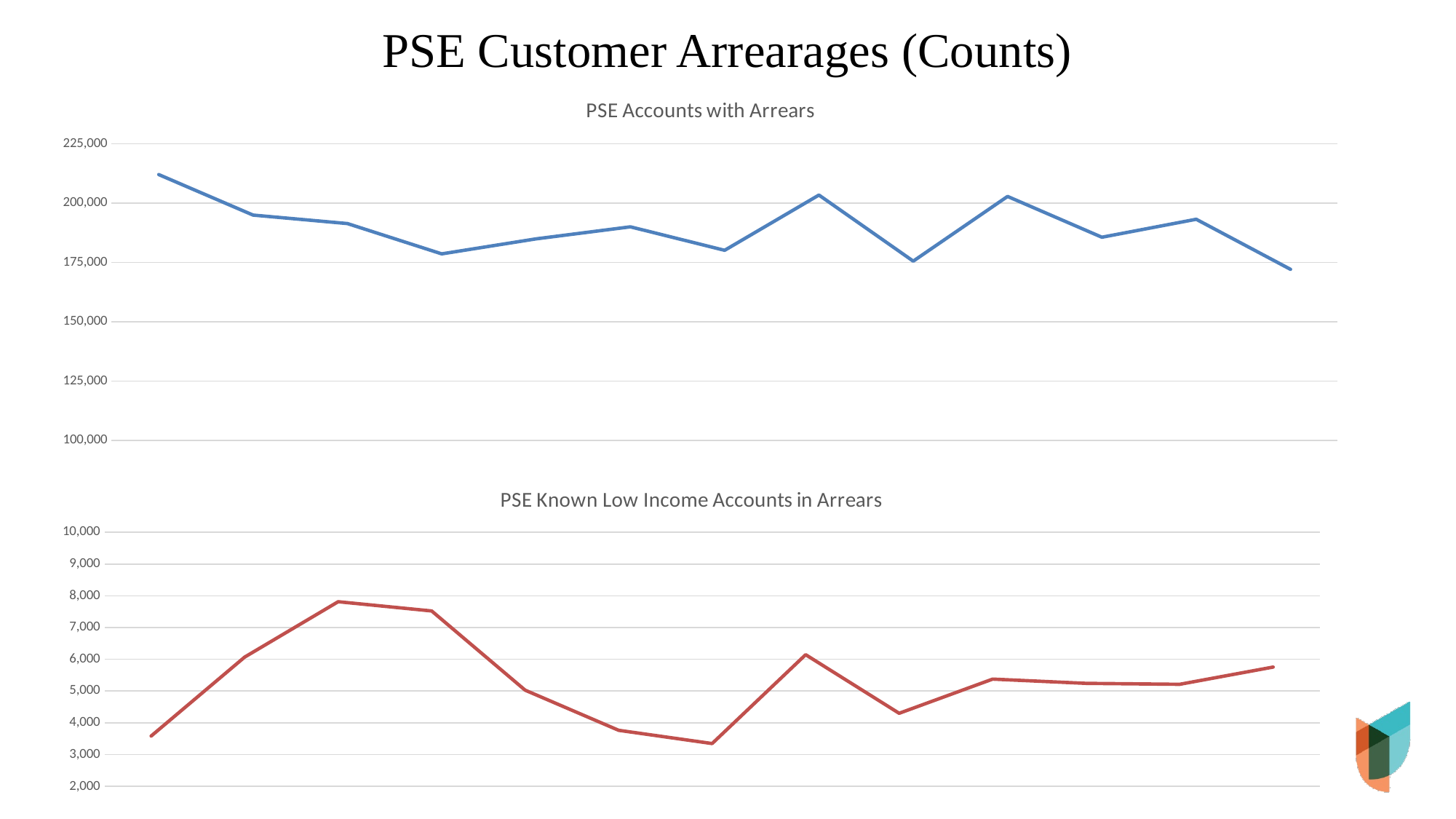
In the top chart, 'PSE Accounts with Arrears', is the first point or the last point higher? the first point In the top chart, 'PSE Accounts with Arrears', is the value of the first point greater or less than 200,000? greater In the top chart, 'PSE Accounts with Arrears', is the value of the last point greater or less than 175,000? less What is the title of the bottom chart on the slide? PSE Known Low Income Accounts in Arrears In the bottom chart, 'PSE Known Low Income Accounts in Arrears', is the highest point on the line greater or less than 7,000? greater What kind of chart is the top chart, 'PSE Accounts with Arrears'? line chart In the top chart, 'PSE Accounts with Arrears', how many data points are plotted on the line? 13 What kind of chart is the bottom chart, 'PSE Known Low Income Accounts in Arrears'? line chart In the top chart, 'PSE Accounts with Arrears', do the values overall rise or fall from the first point to the last point? fall In the bottom chart, 'PSE Known Low Income Accounts in Arrears', how many data points are plotted on the line? 13